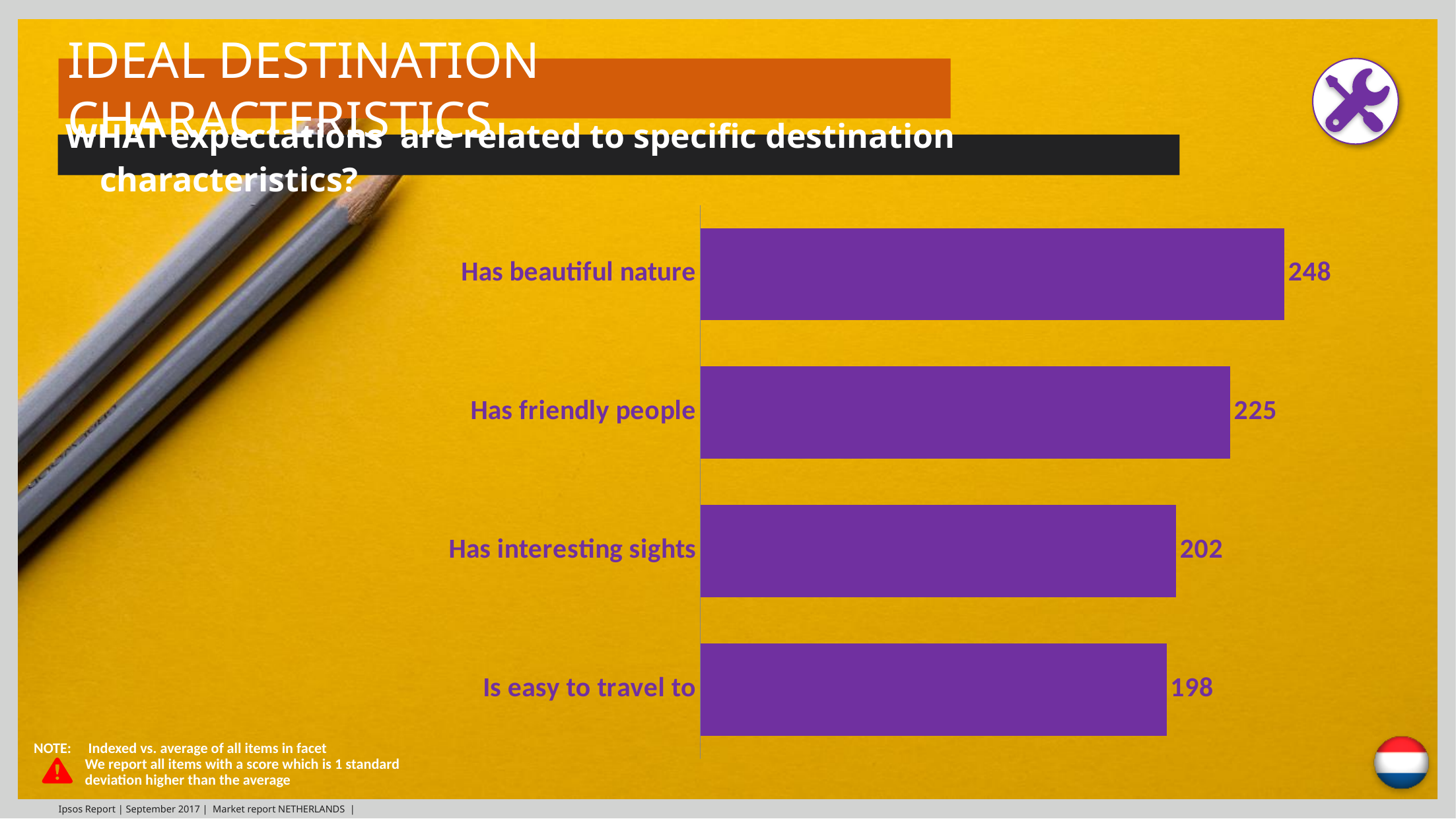
What colour are the bars in the chart? Purple What is the difference between the values for "Has beautiful nature" and "Has friendly people"? 23 What is the value for "Has beautiful nature"? 248 What kind of chart is shown on the slide? Bar chart What is the value for "Has friendly people"? 225 What is the value for "Has interesting sights"? 202 Which category has the highest value? Has beautiful nature What is the difference between the values for "Has interesting sights" and "Is easy to travel to"? 4 What is the value for "Is easy to travel to"? 198 Which is larger, the value for "Has friendly people" or the value for "Has interesting sights"? Has friendly people How many categories are shown in the chart? 4 Which category has the lowest value? Is easy to travel to